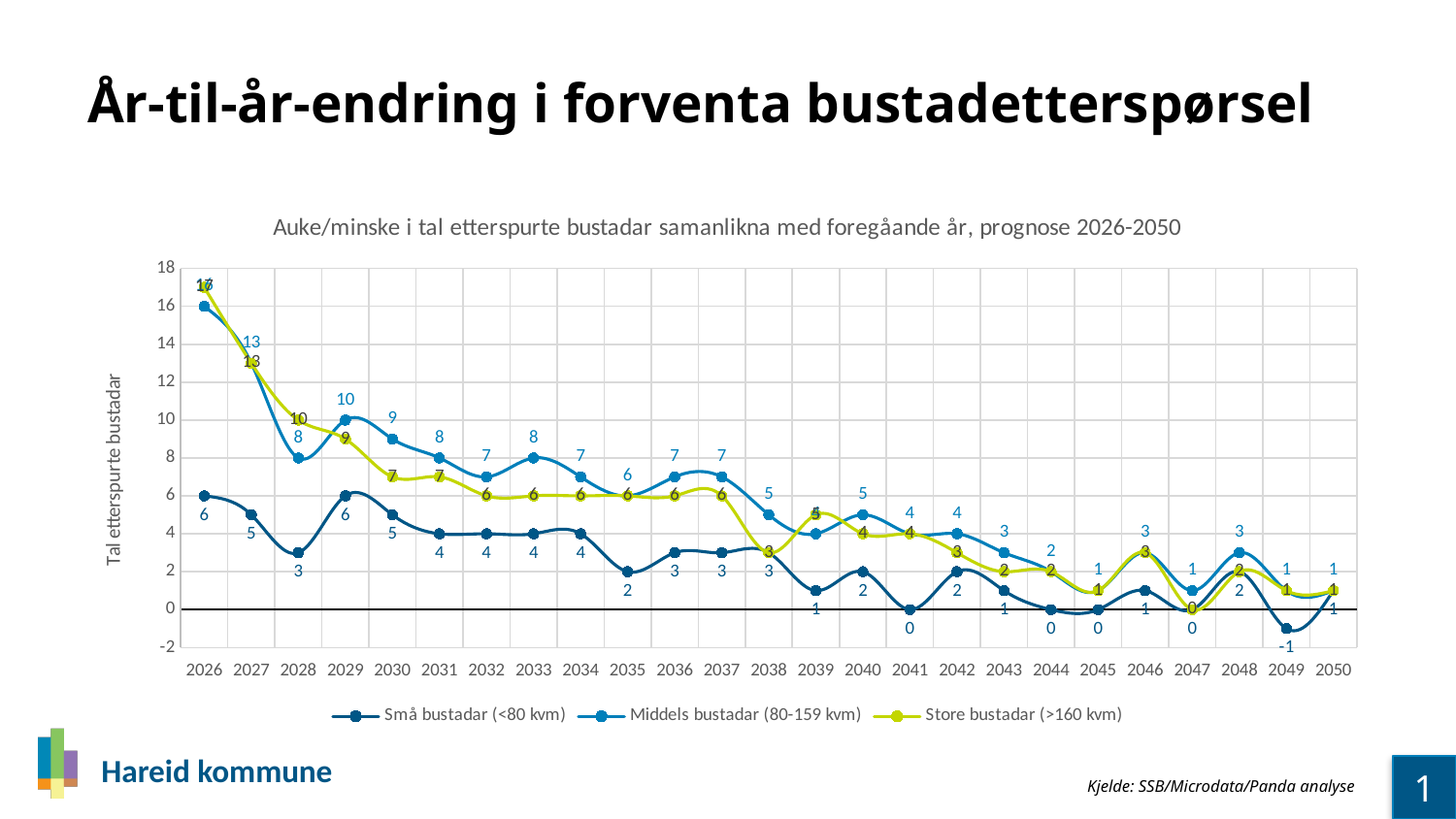
How many years are plotted along the x axis? 25 What is the value for Middels bustadar (80-159 kvm) in 2029? 10 How many series does the legend list? 3 In which year is the value for Middels bustadar (80-159 kvm) highest? 2026 What is the value for Middels bustadar (80-159 kvm) in 2040? 5 What is the difference between Middels bustadar (80-159 kvm) and Små bustadar (<80 kvm) in 2029? 4 What kind of chart is shown on the slide? Line chart In 2040, which is larger: Middels bustadar (80-159 kvm) or Store bustadar (>160 kvm)? Middels bustadar (80-159 kvm) What is the value for Store bustadar (>160 kvm) in 2039? 5 What is the value for Små bustadar (<80 kvm) in 2035? 2 In which year is the value for Små bustadar (<80 kvm) lowest? 2049 Does the Middels bustadar (80-159 kvm) series generally rise or fall from 2026 to 2050? Fall